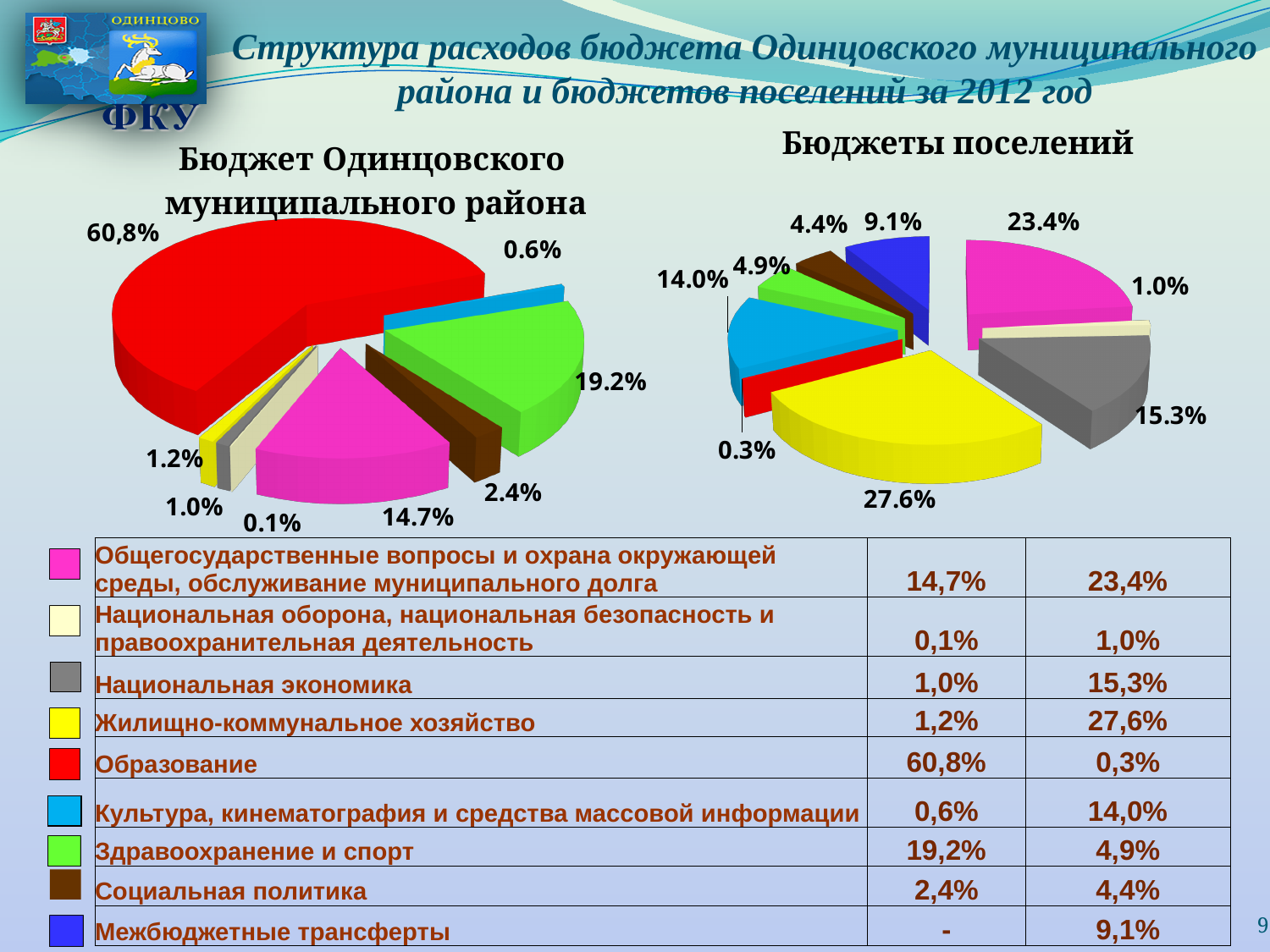
In the chart 'Бюджет Одинцовского муниципального района', which is larger: the slice for Социальная политика or the slice for Жилищно-коммунальное хозяйство? Социальная политика In the chart 'Бюджеты поселений', what is the value of the slice for Жилищно-коммунальное хозяйство? 27.6% In the chart 'Бюджеты поселений', what is the difference between the slices for Общегосударственные вопросы (23.4%) and Национальная экономика (15.3%)? 8.1% In the chart 'Бюджет Одинцовского муниципального района', what share does the largest slice (Образование) have? 60,8% How many slices does the chart 'Бюджет Одинцовского муниципального района' have? 8 In the chart 'Бюджет Одинцовского муниципального района', which category has the smallest slice? Национальная оборона, национальная безопасность и правоохранительная деятельность In the chart 'Бюджет Одинцовского муниципального района', what is the value of the slice for Здравоохранение и спорт? 19.2% What type of chart is used for 'Бюджеты поселений'? Pie chart In the chart 'Бюджеты поселений', what is the value for Межбюджетные трансферты? 9.1% In the chart 'Бюджеты поселений', what is the smallest slice value? 0.3% How many slices does the chart 'Бюджеты поселений' have? 9 In the chart 'Бюджеты поселений', which category has the largest slice? Жилищно-коммунальное хозяйство